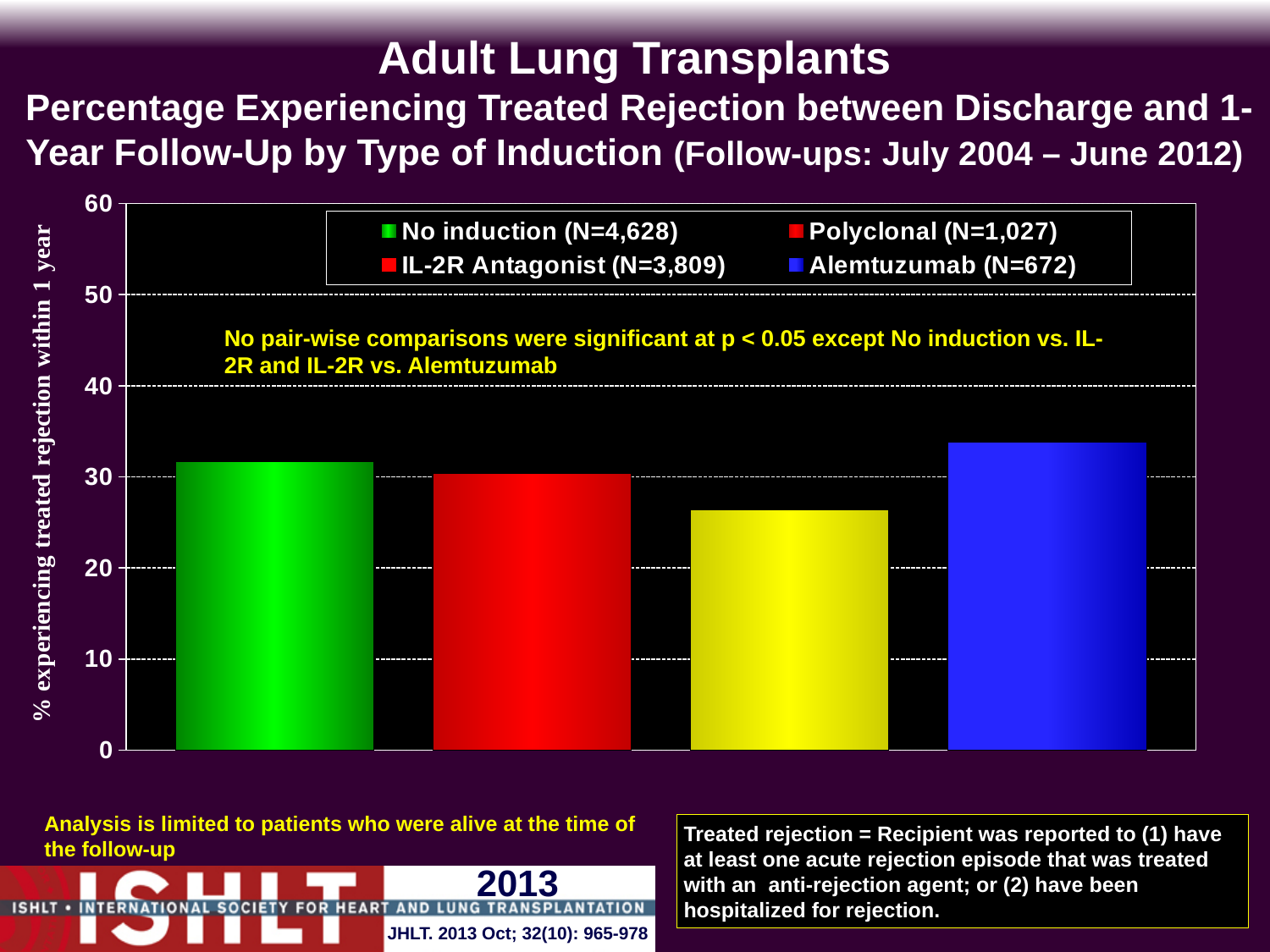
What kind of chart is shown on the slide? bar chart What is the sample size (N) shown in the legend for No induction? 4,628 Which induction type has the highest percentage experiencing treated rejection within 1 year? Alemtuzumab Is the value for Polyclonal greater or less than 40? less Which induction type has the lowest percentage experiencing treated rejection within 1 year? IL-2R Antagonist How many entries does the legend list? 4 What colour is the bar for Alemtuzumab? blue Is the value for No induction greater or less than 30? greater Is the value for IL-2R Antagonist greater or less than 30? less How many bars are plotted in the chart? 4 Which is larger, the value for Alemtuzumab or the value for IL-2R Antagonist? Alemtuzumab